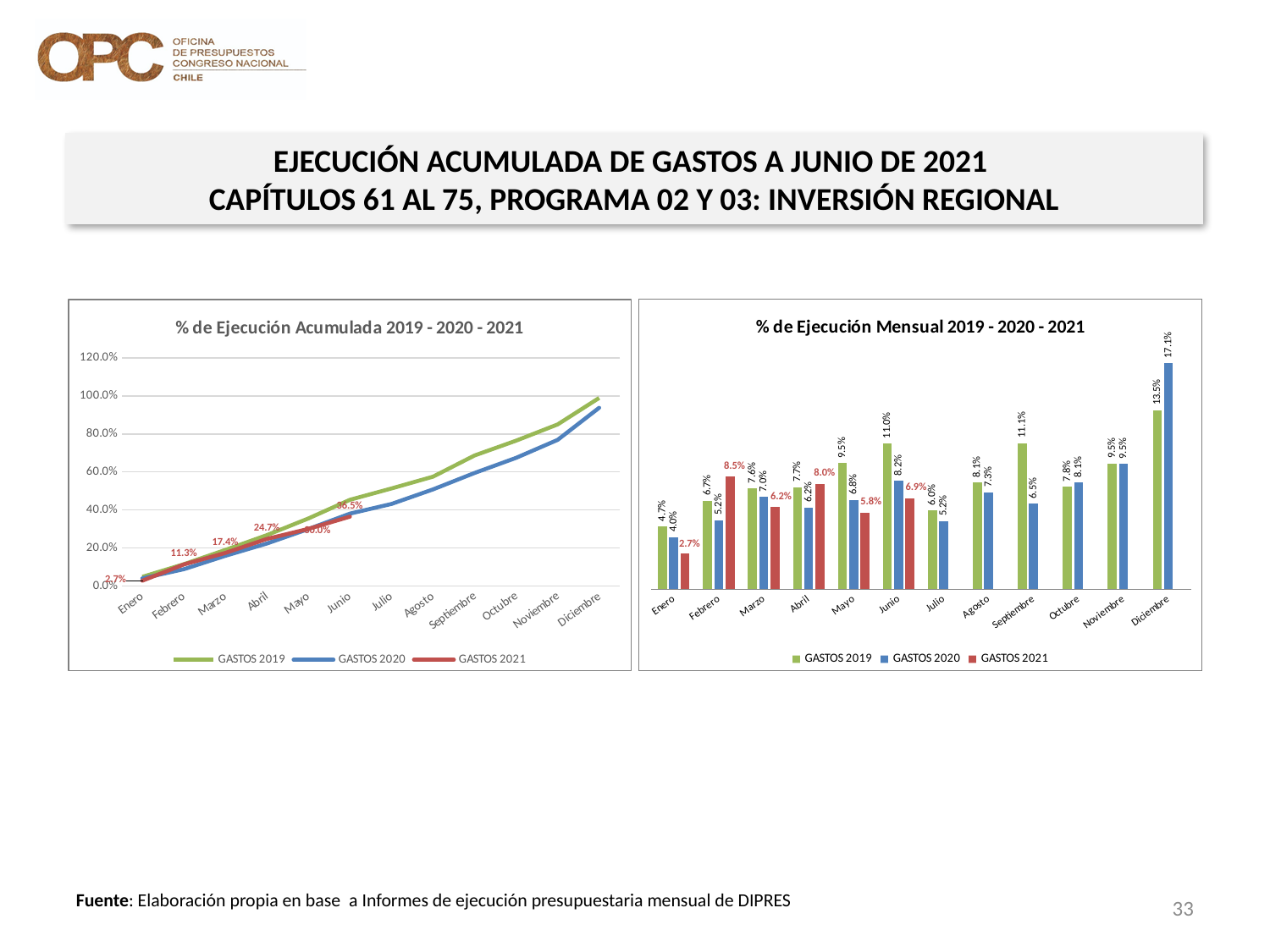
In the chart '% de Ejecución Acumulada 2019 - 2020 - 2021', do the GASTOS 2020 values rise or fall from Enero to Diciembre? Rise In the chart '% de Ejecución Acumulada 2019 - 2020 - 2021', what is the value for GASTOS 2021 in Marzo? 17.4% In the chart '% de Ejecución Mensual 2019 - 2020 - 2021', which is larger in Abril: GASTOS 2021 or GASTOS 2020? GASTOS 2021 In the chart '% de Ejecución Mensual 2019 - 2020 - 2021', what is the value for GASTOS 2021 in Febrero? 8.5% In the chart '% de Ejecución Mensual 2019 - 2020 - 2021', what is the value for GASTOS 2020 in Diciembre? 17.1% In the chart '% de Ejecución Mensual 2019 - 2020 - 2021', what is the difference between GASTOS 2019 and GASTOS 2020 in Junio? 2.8% What kind of chart is '% de Ejecución Mensual 2019 - 2020 - 2021'? Bar chart In the chart '% de Ejecución Mensual 2019 - 2020 - 2021', which month has the lowest value for GASTOS 2021? Enero In the chart '% de Ejecución Acumulada 2019 - 2020 - 2021', what is the value for GASTOS 2021 in Junio? 36.5% In the chart '% de Ejecución Acumulada 2019 - 2020 - 2021', is the value for GASTOS 2019 in Diciembre greater or less than 80.0%? greater In the chart '% de Ejecución Mensual 2019 - 2020 - 2021', how many series does the legend list? 3 In the chart '% de Ejecución Mensual 2019 - 2020 - 2021', which month has the highest value for GASTOS 2019? Diciembre